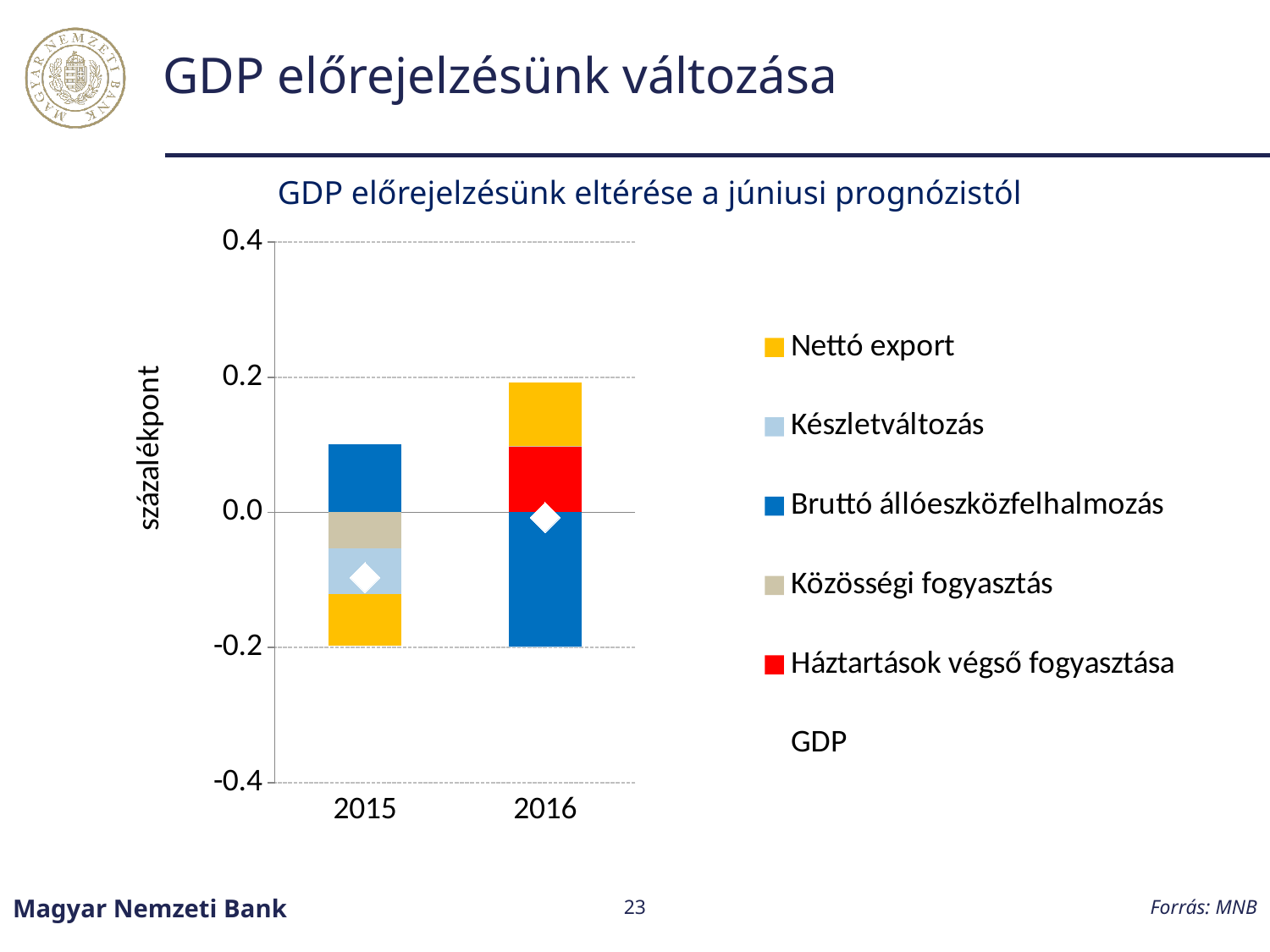
How many years (categories) are shown on the x axis of the chart? 2 Is the Bruttó állóeszközfelhalmozás segment for 2016 greater or less than 0.0? less How many entries does the chart's legend list? 6 What is the title of the chart? GDP előrejelzésünk eltérése a júniusi prognózistól Is the top of the stacked bar for 2015 greater or less than 0.2? less Which year has the higher top of its stacked bar, 2015 or 2016? 2016 Is the GDP marker for 2015 greater or less than 0.0? less Is the Nettó export segment for 2016 positive or negative? positive Which year has the higher GDP marker, 2015 or 2016? 2016 What kind of chart is shown on the slide? Stacked bar chart What is the label on the chart's vertical axis? százalékpont